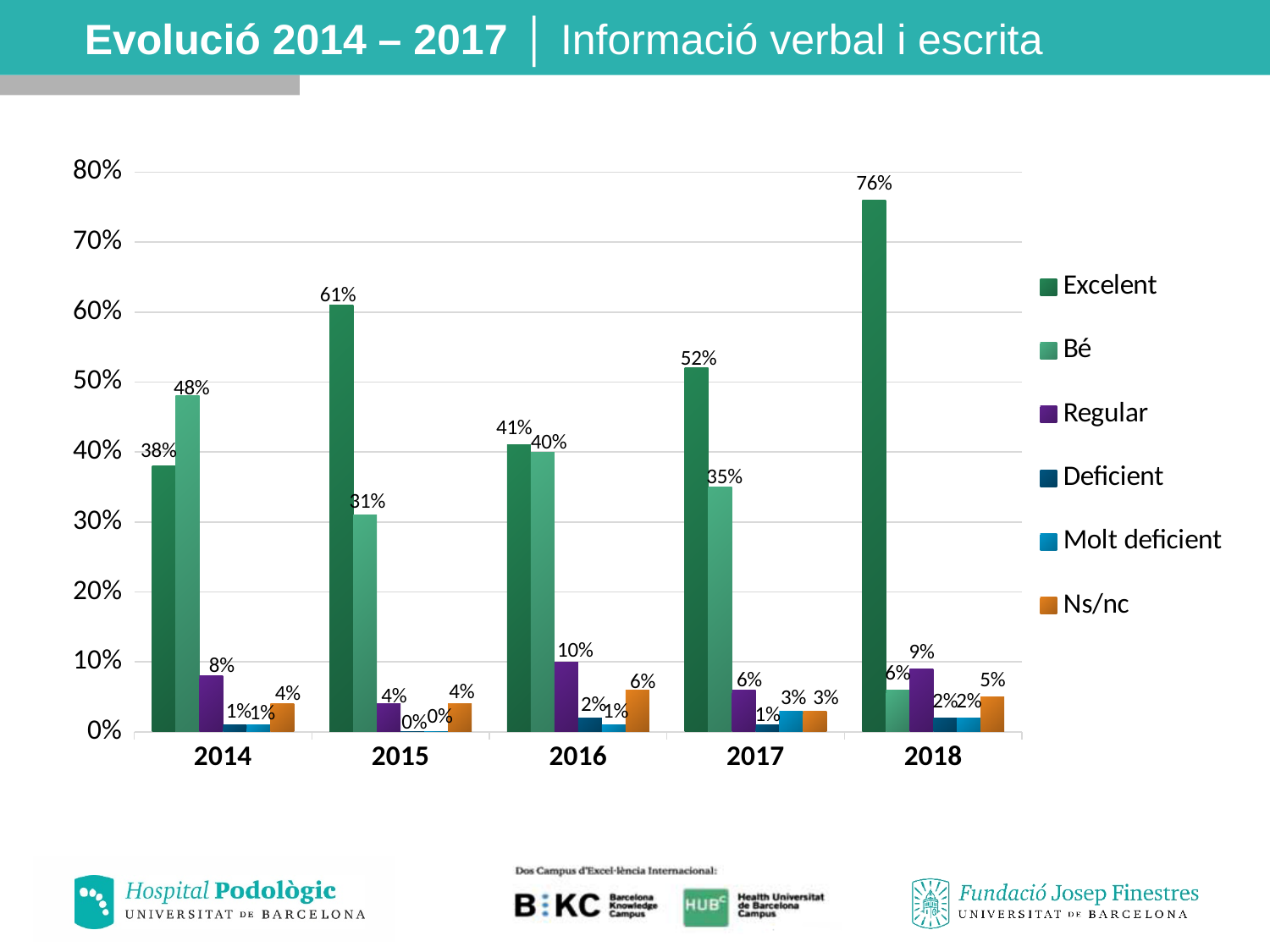
In which year is the Excelent value highest? 2018 Is the value for Excelent in 2015 greater or less than 50%? greater Which is larger in 2014, Excelent or Bé? Bé How many series does the legend list? 6 What is the value for Bé in 2014? 48% What is the value for Excelent in 2018? 76% In which year is the Bé value lowest? 2018 What is the value for Ns/nc in 2017? 3% What is the difference between the Excelent values for 2018 and 2017? 24% What kind of chart is shown on the slide? bar chart How many years are shown on the x axis? 5 What is the value for Regular in 2016? 10%